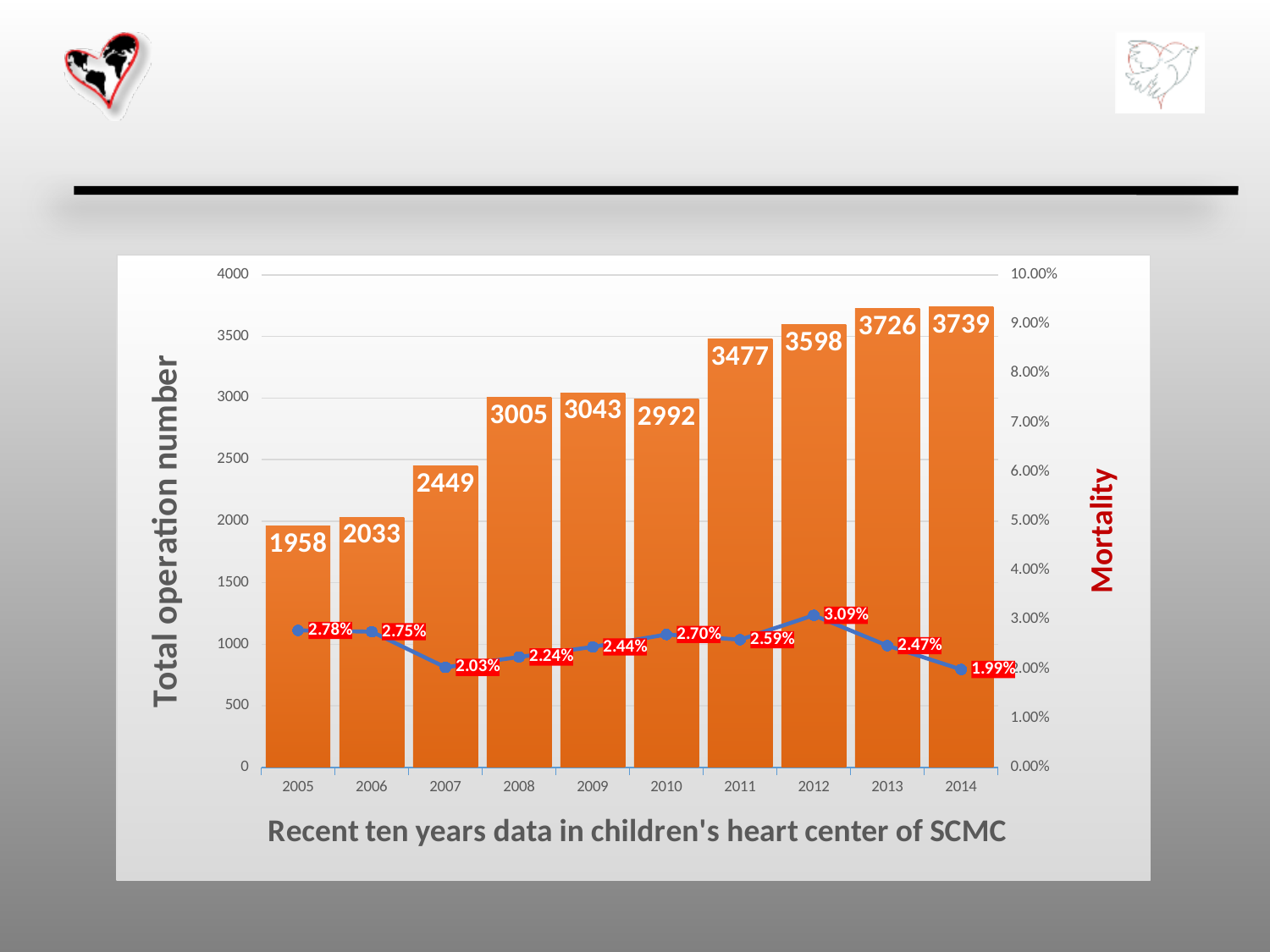
What type of chart is used to show the total operation number? bar chart Which year had the highest total operation number? 2014 Which year had a higher total operation number, 2009 or 2010? 2009 Which year had the lowest mortality rate? 2014 What is the label of the right-hand vertical axis? Mortality What was the total operation number in 2011? 3477 Which year had the lowest total operation number? 2005 What was the mortality rate in 2012? 3.09% How many years are shown on the x axis? 10 What is the overall trend of the total operation number from 2005 to 2014? rising What is the title of the chart? Recent ten years data in children's heart center of SCMC What is the difference in total operation number between 2014 and 2005? 1781